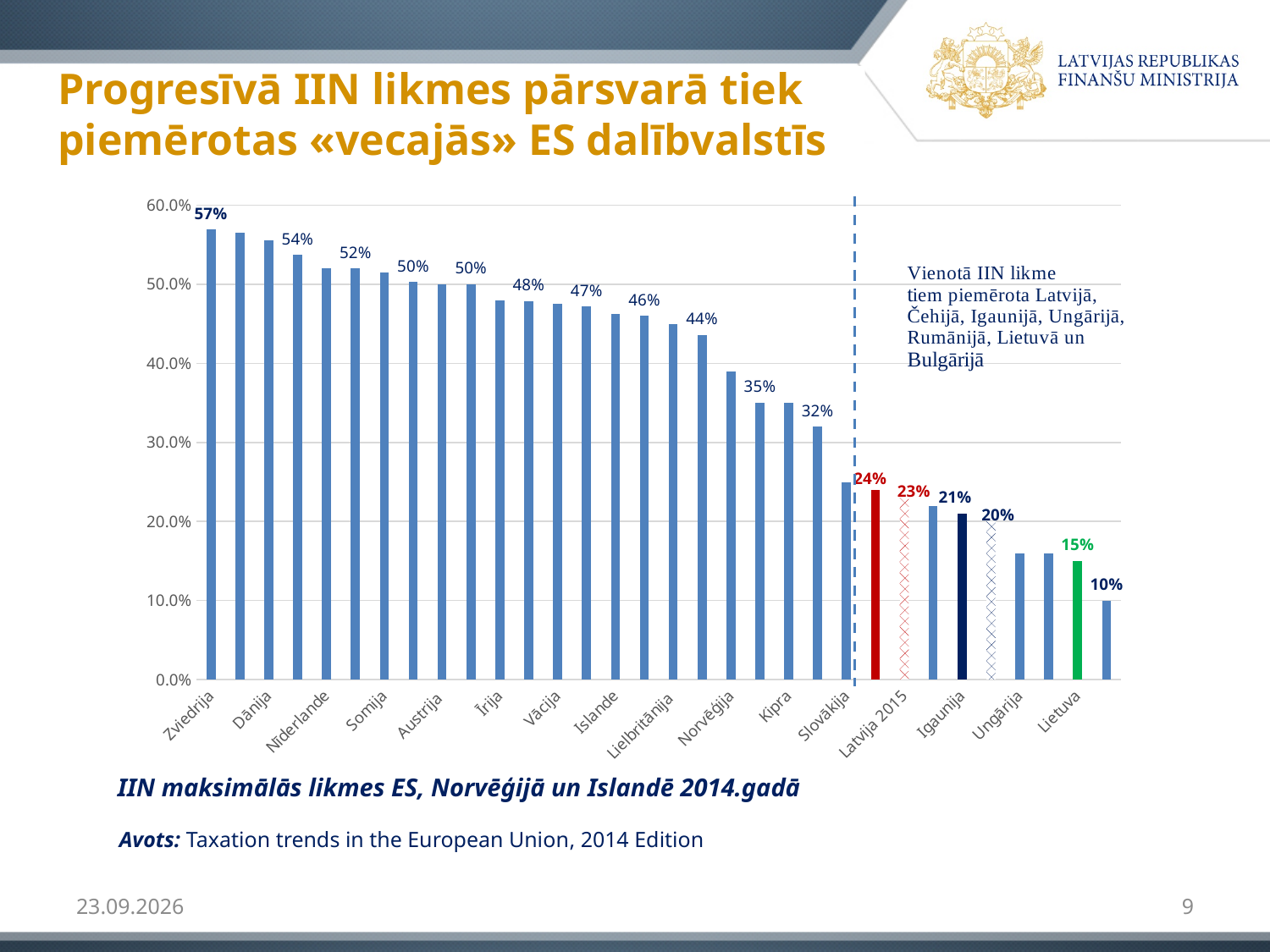
What is the difference between the values for Latvija 2015 and Igaunija? 2 percentage points Is the value for Slovākija greater or less than 20.0%? greater What is the value shown for Igaunija? 21% What is the difference between the values for Zviedrija and Lietuva? 42 percentage points Do the values rise or fall from left to right along the x axis? fall Which has the larger value, Igaunija or Lietuva? Igaunija Which labelled country has the highest value in the chart? Zviedrija What is the value shown for Lietuva? 15% What is the value shown for Latvija 2015? 23% Is the value for Ungārija greater or less than 20.0%? less What is the value shown for Zviedrija? 57% What kind of chart is shown on the slide? bar chart